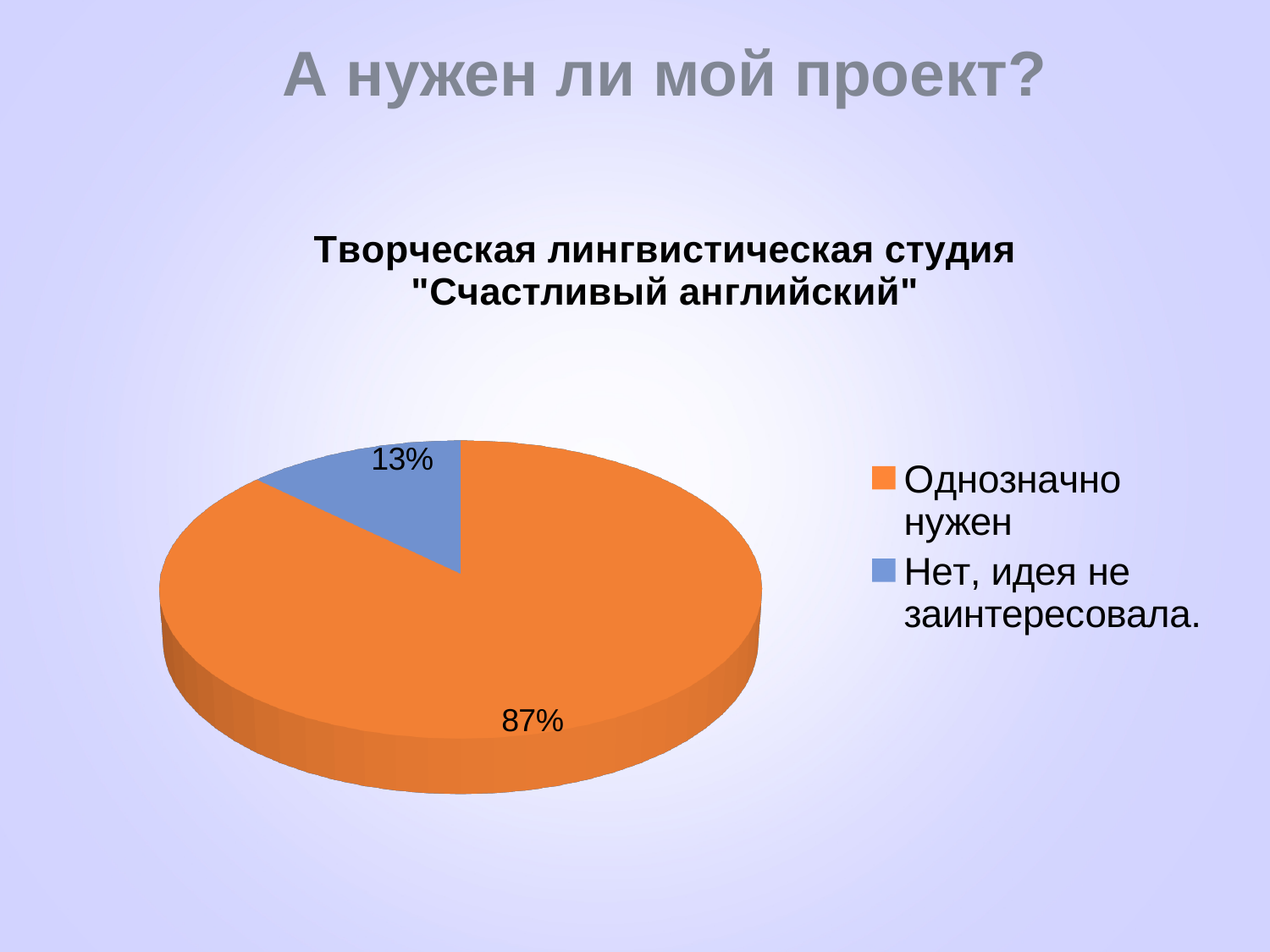
What is the title of the chart? Творческая лингвистическая студия "Счастливый английский" What share of the pie does "Нет, идея не заинтересовала." take? 13% Which slice of the pie is the smallest? Нет, идея не заинтересовала. What colour is the "Нет, идея не заинтересовала." slice? Blue Which is larger: the "Однозначно нужен" slice or the "Нет, идея не заинтересовала." slice? Однозначно нужен What is the difference in percentage points between the "Однозначно нужен" slice and the "Нет, идея не заинтересовала." slice? 74 What share of the pie does "Однозначно нужен" take? 87% What kind of chart is shown on the slide? Pie chart How many slices does the pie chart have? 2 How many entries does the legend list? 2 Which slice of the pie is the largest? Однозначно нужен